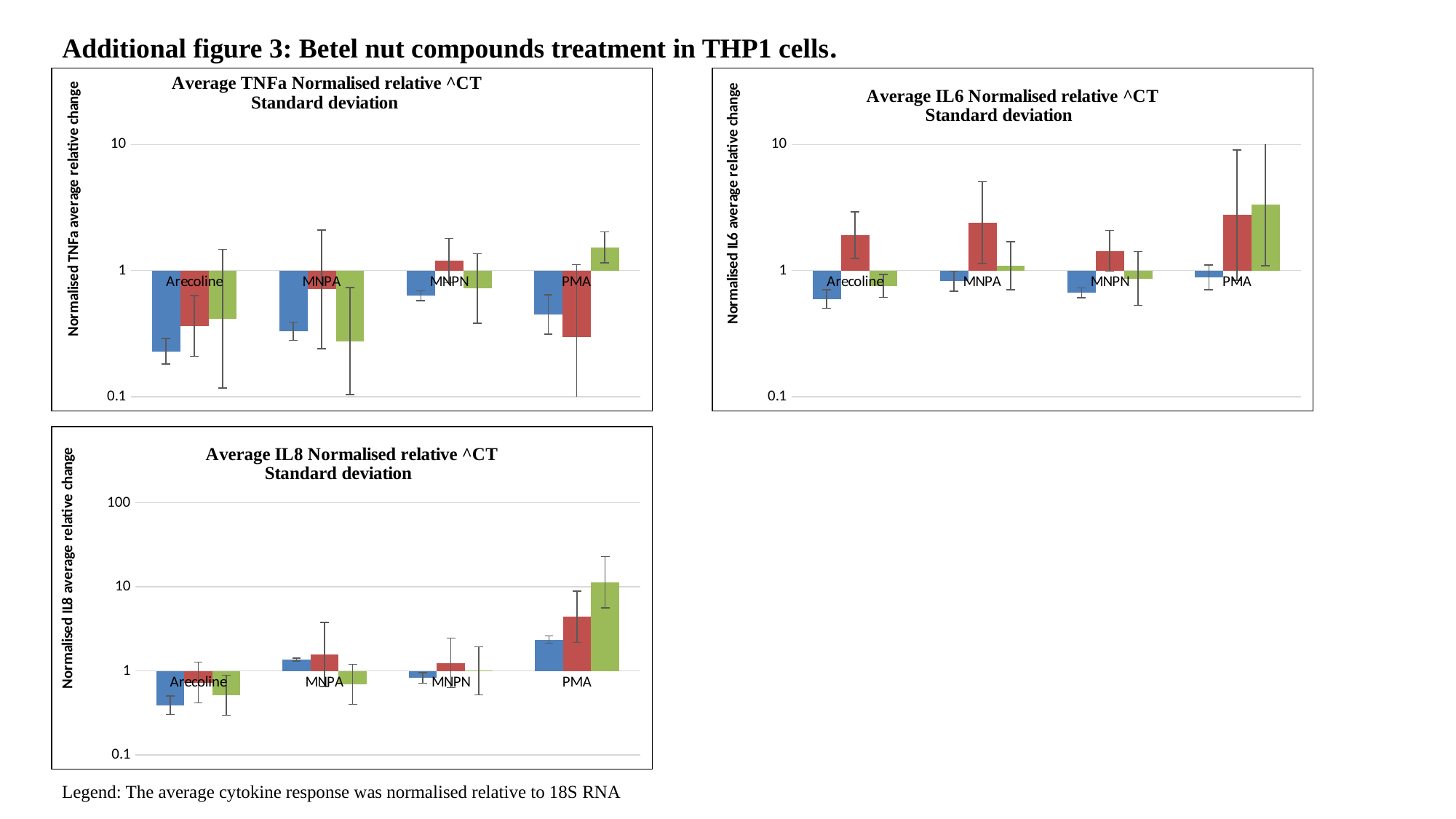
How many categories are shown on the x axis of the "Average IL6 Normalised relative ^CT Standard deviation" chart? 4 In the "Average IL8 Normalised relative ^CT Standard deviation" chart, is the green bar larger for PMA or for Arecoline? PMA In the "Average IL6 Normalised relative ^CT Standard deviation" chart, is the value of the red bar for PMA greater or less than 1? greater What kind of chart is the "Average TNFa Normalised relative ^CT Standard deviation" chart? bar chart In the "Average TNFa Normalised relative ^CT Standard deviation" chart, is the value of the blue bar for Arecoline greater or less than 1? less How many bars are plotted for each category in the "Average IL8 Normalised relative ^CT Standard deviation" chart? 3 In the "Average TNFa Normalised relative ^CT Standard deviation" chart, is the value of the green bar for PMA greater or less than 1? greater In the "Average IL6 Normalised relative ^CT Standard deviation" chart, which category has the tallest bar? PMA What is the y-axis label of the "Average IL8 Normalised relative ^CT Standard deviation" chart? Normalised IL8 average relative change In the "Average IL6 Normalised relative ^CT Standard deviation" chart, is the red bar larger for MNPA or for MNPN? MNPA In the "Average IL8 Normalised relative ^CT Standard deviation" chart, which category has the tallest bar? PMA